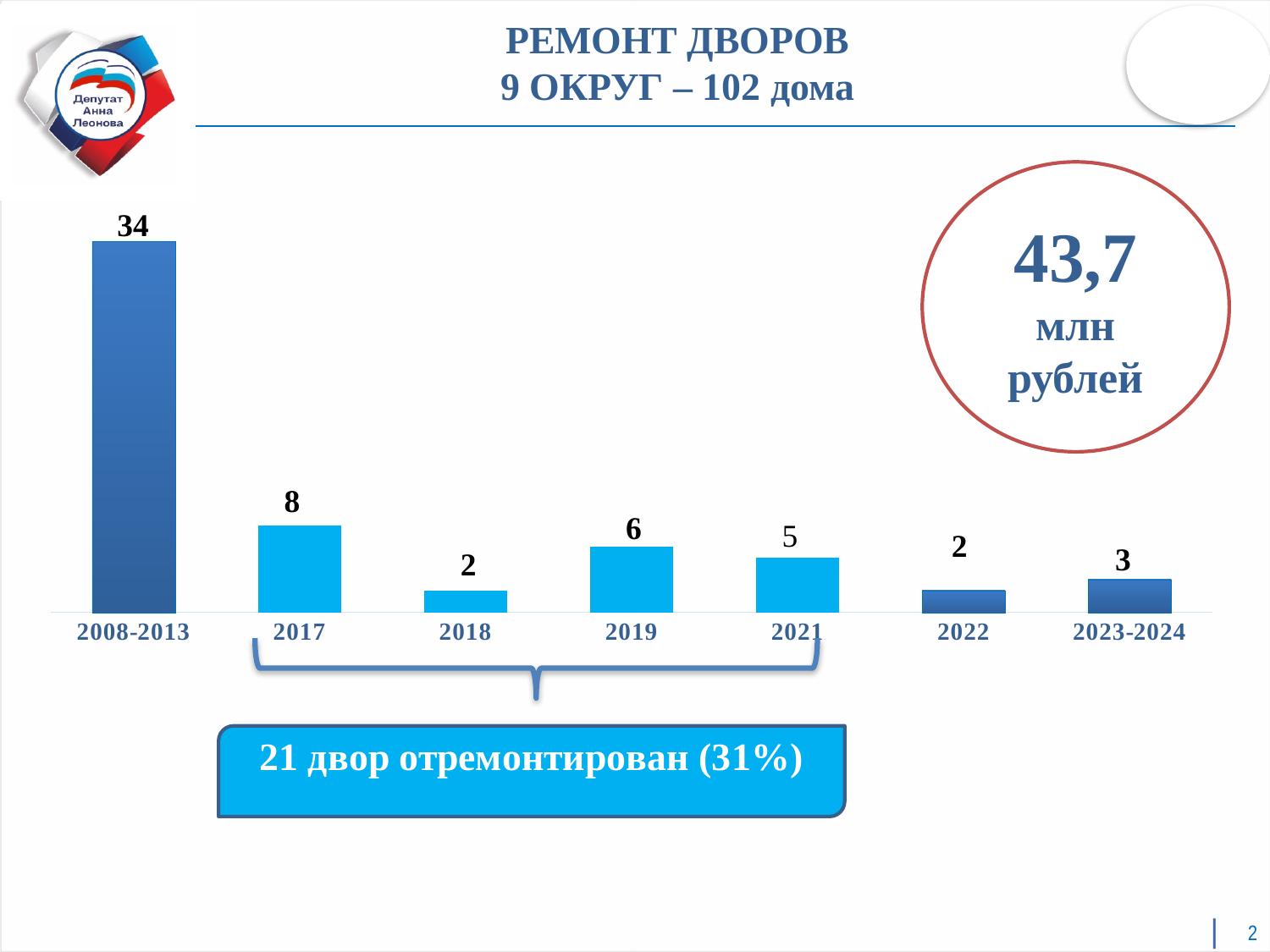
How many categories are shown on the x axis? 7 What is the value for 2019? 6 What is the value for 2008-2013? 34 Which categories have the lowest value? 2018 and 2022 What is the title of the slide? РЕМОНТ ДВОРОВ 9 ОКРУГ – 102 дома What is the value for 2017? 8 What is the total of the values for 2017, 2018, 2019 and 2021? 21 Which is larger, the value for 2019 or the value for 2022? 2019 Which category has the highest value? 2008-2013 What is the value for 2023-2024? 3 What kind of chart is shown on the slide? bar chart What is the difference between the values for 2017 and 2021? 3